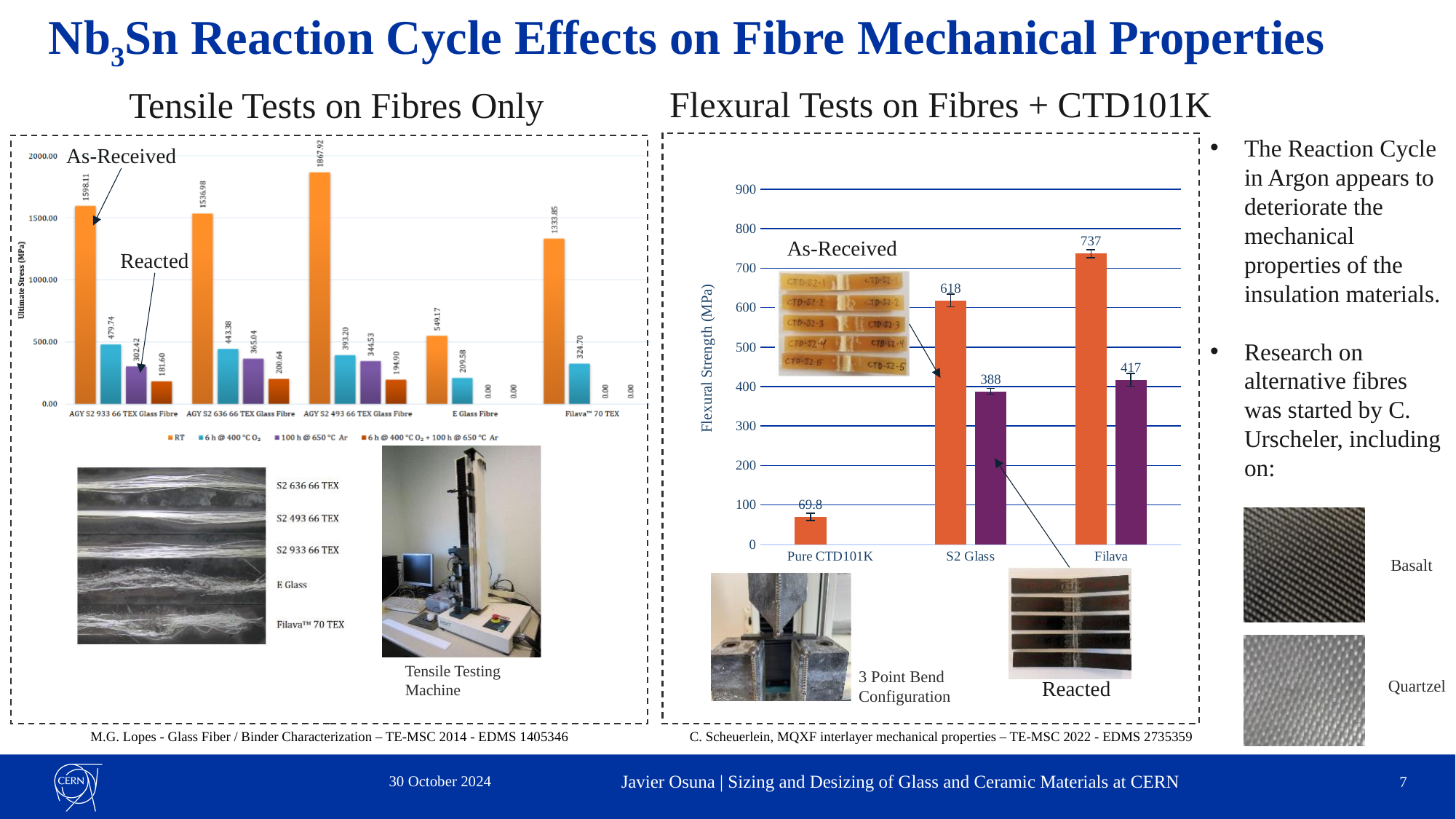
In the Flexural Tests on Fibres + CTD101K chart, what is the flexural strength of Pure CTD101K? 69.8 In the Flexural Tests on Fibres + CTD101K chart, which bar has the highest value? Filava as-received (737) In the Flexural Tests on Fibres + CTD101K chart, what is the reacted flexural strength of S2 Glass? 388 In the Flexural Tests on Fibres + CTD101K chart, what is the as-received flexural strength of Filava? 737 In the Tensile Tests on Fibres Only chart, which fibre has the highest RT ultimate stress? AGY S2 493 66 TEX Glass Fibre What kind of chart is the Tensile Tests on Fibres Only chart? Bar chart In the Flexural Tests on Fibres + CTD101K chart, how many categories are shown on the x axis? 3 In the Tensile Tests on Fibres Only chart, what is the RT ultimate stress of Filava 70 TEX? 1333.85 In the Tensile Tests on Fibres Only chart, what is the RT ultimate stress of AGY S2 493 66 TEX Glass Fibre? 1867.92 In the Flexural Tests on Fibres + CTD101K chart, what is the label of the y axis? Flexural Strength (MPa) In the Tensile Tests on Fibres Only chart, how many series does the legend list? 4 In the Flexural Tests on Fibres + CTD101K chart, what is the difference between the as-received and reacted values for Filava? 320